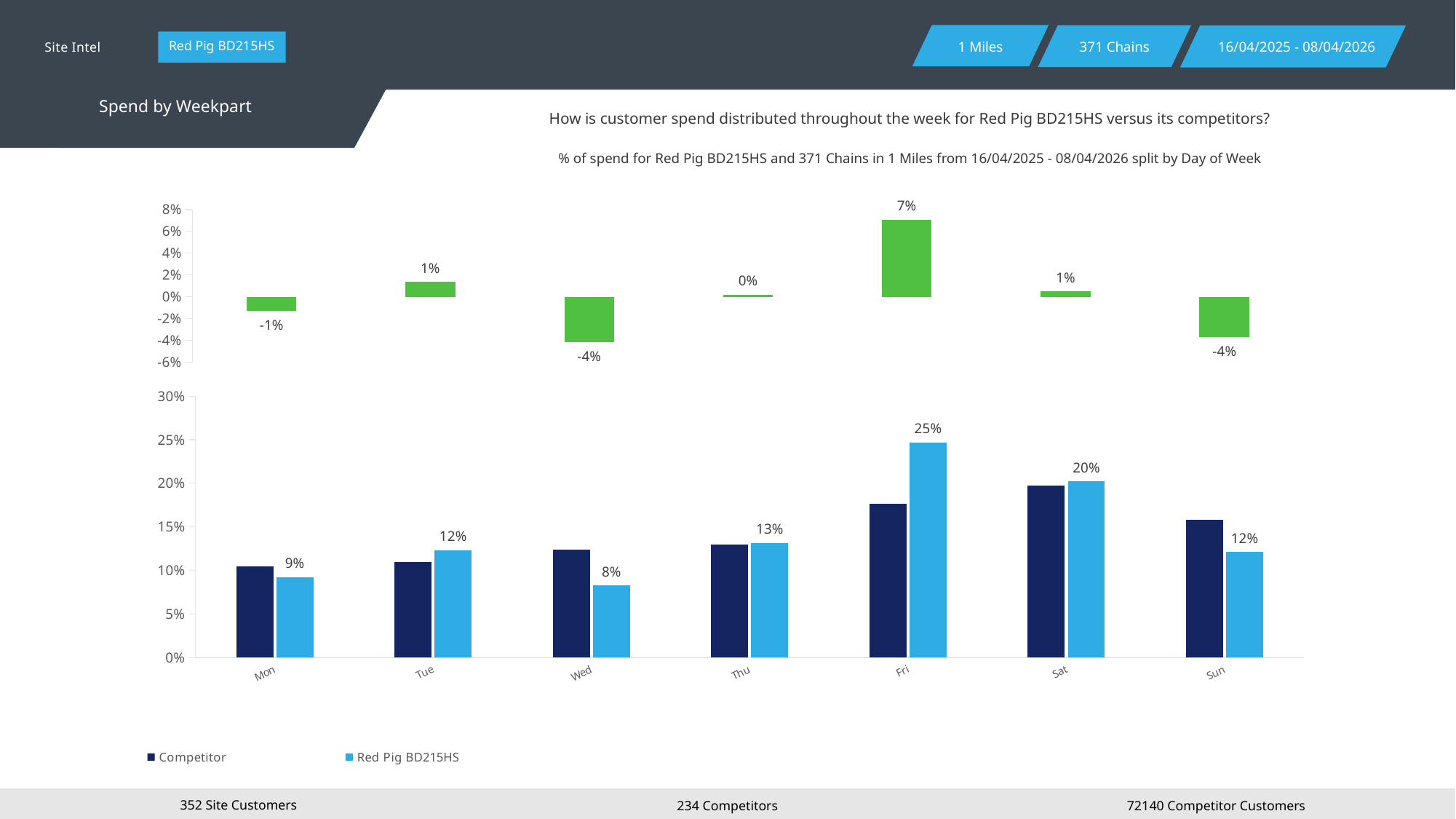
In the top chart, which day has the highest value? Fri How many days are shown on the x axis of the bottom chart? 7 How many series does the legend of the bottom chart list? 2 In the bottom chart, what is the Red Pig BD215HS value for Fri? 25% In the bottom chart, is the Competitor value for Mon greater or less than 15%? less In the bottom chart, what is the Red Pig BD215HS value for Wed? 8% In the bottom chart, what is the difference between the Red Pig BD215HS values for Fri and Sat? 5% In the bottom chart, which day has the highest Red Pig BD215HS value? Fri In the top chart, what is the value for Fri? 7% In the bottom chart, for Fri, which is larger: the Competitor bar or the Red Pig BD215HS bar? Red Pig BD215HS In the bottom chart, which day has the lowest Red Pig BD215HS value? Wed In the bottom chart, is the Competitor value for Sat greater or less than 15%? greater